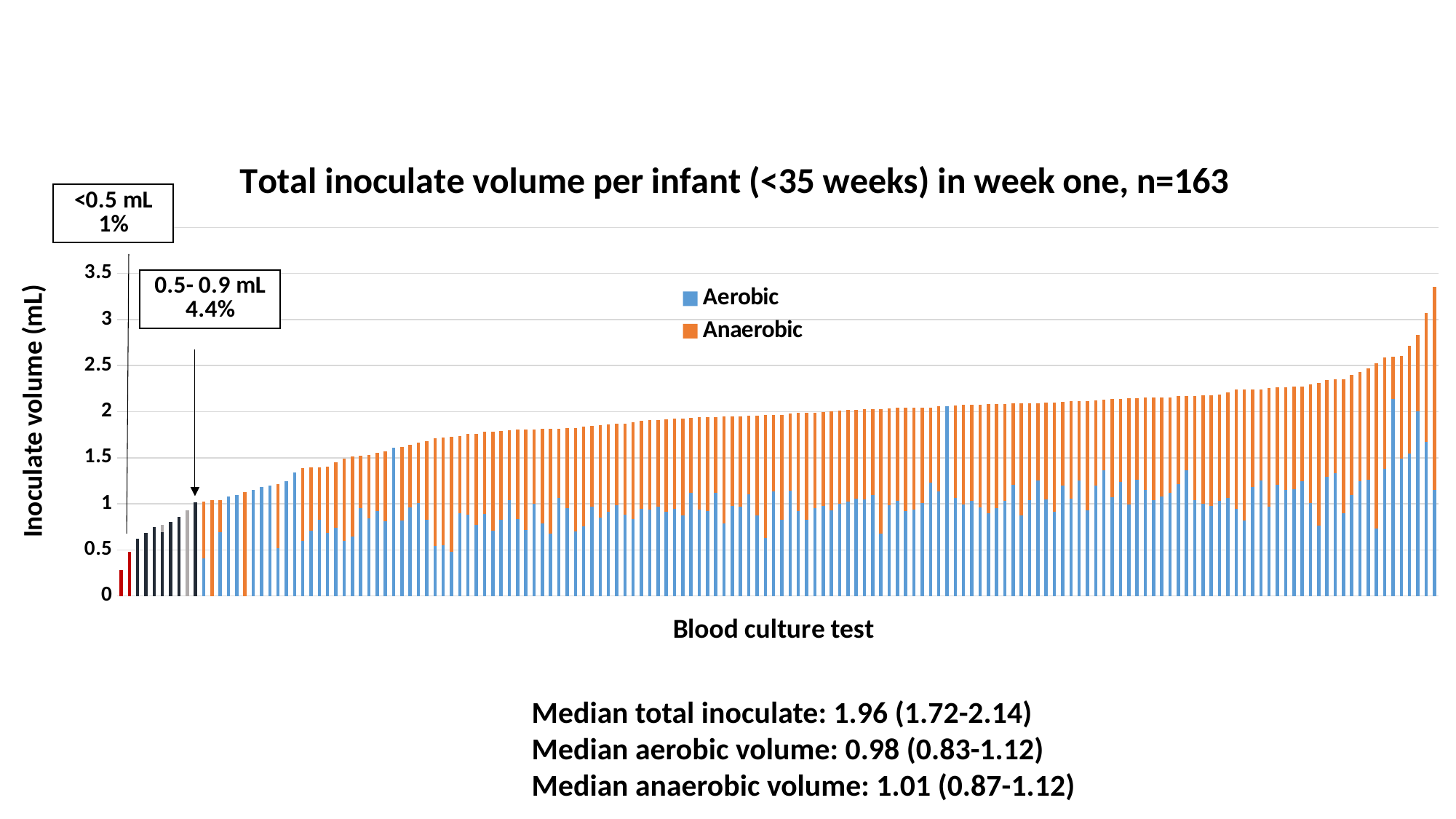
What percentage of tests had a total inoculate volume of 0.5-0.9 mL, according to the annotation? 4.4% How many blood culture tests (n) are plotted in the chart? 163 What is the median total inoculate volume stated on the slide? 1.96 (1.72-2.14) Which median volume is larger, aerobic or anaerobic? anaerobic What are the two series named in the legend? Aerobic and Anaerobic Is the total volume of the shortest bar (leftmost) greater or less than 0.5 mL? less Do the total inoculate volumes rise or fall from left to right along the x axis? rise How many series does the legend list? 2 What percentage of tests had a total inoculate volume below 0.5 mL, according to the annotation? 1% Is the total volume of the tallest bar greater or less than 3 mL? greater What is the title of the chart? Total inoculate volume per infant (<35 weeks) in week one, n=163 What kind of chart is shown on the slide? bar chart